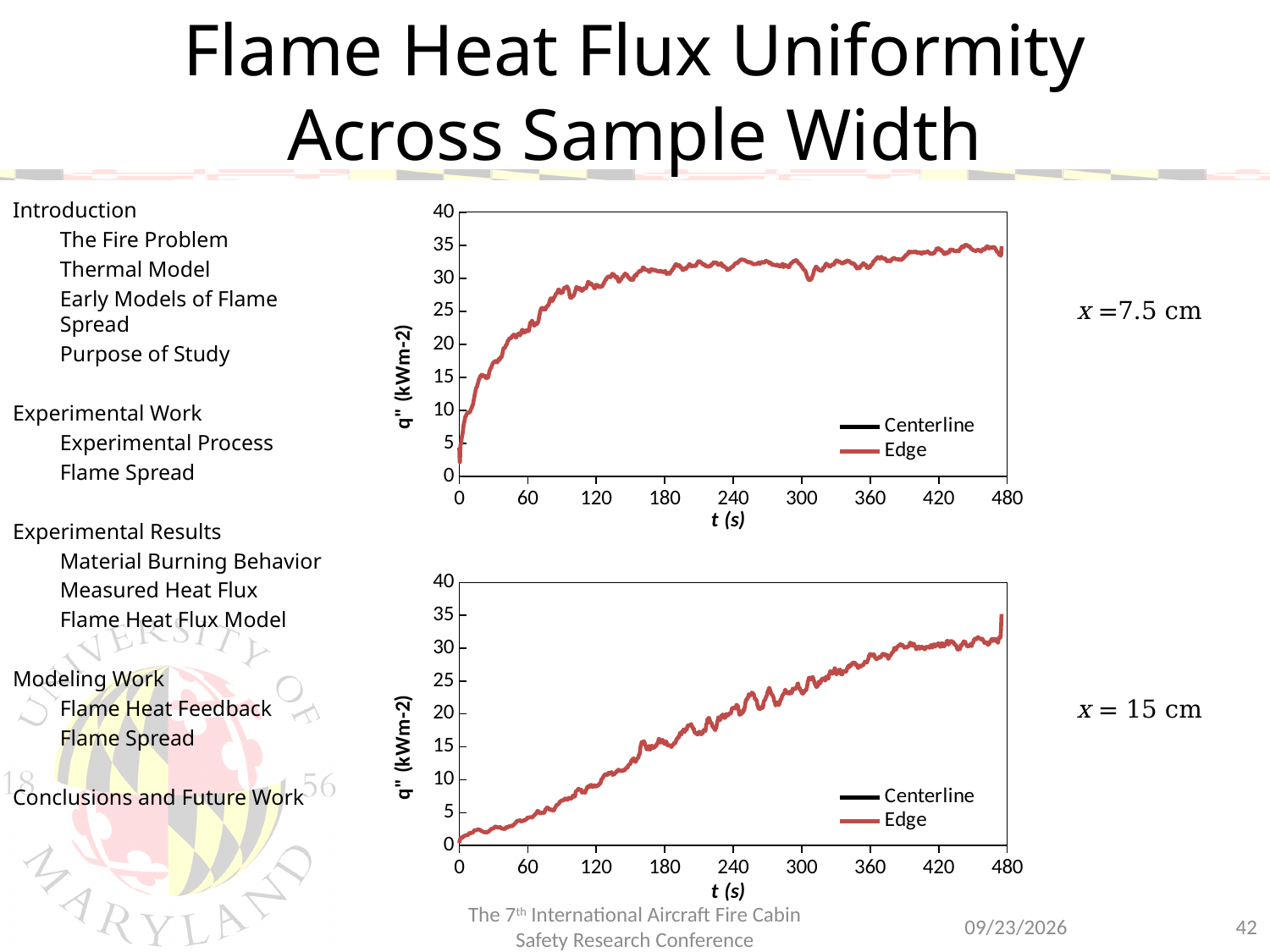
In the bottom chart (x = 15 cm), does the Edge heat flux generally rise or fall as t increases? rise In the top chart (x = 7.5 cm), is the Edge value at t = 480 s greater or less than 30? greater In the top chart (x = 7.5 cm), is the Edge value at t = 60 s greater or less than 15? greater How many series does the legend of the top chart (x = 7.5 cm) list? 2 What is the label of the x axis on the top chart (x = 7.5 cm)? t (s) In the bottom chart (x = 15 cm), is the Edge value at t = 240 s greater or less than 25? less At t = 120 s, is the Edge heat flux larger in the top chart (x = 7.5 cm) or the bottom chart (x = 15 cm)? top chart (x = 7.5 cm) In the top chart (x = 7.5 cm), does the Edge heat flux generally rise or fall as t increases? rise What are the two series named in the legend of the bottom chart (x = 15 cm)? Centerline and Edge What kind of chart is the top chart (x = 7.5 cm)? line chart What kind of chart is the bottom chart (x = 15 cm)? line chart